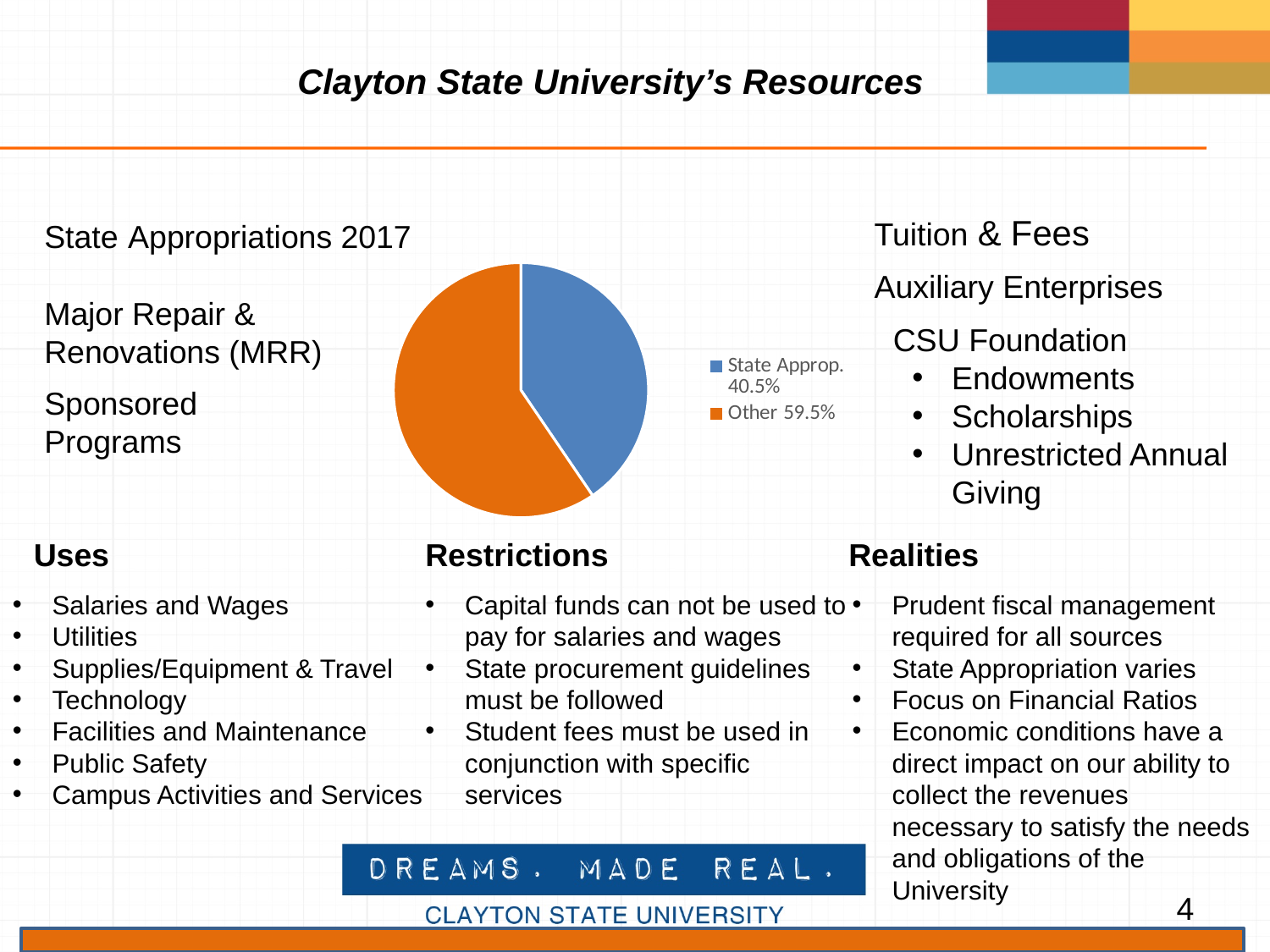
What is the difference in percentage points between the Other slice and the State Approp. slice? 19 percentage points How many slices does the pie chart have? 2 How many entries does the pie chart's legend list? 2 Which is larger in the pie chart, State Approp. or Other? Other Which slice of the pie chart is the largest? Other What colour is the Other slice in the pie chart? orange Which slice of the pie chart is the smallest? State Approp. What kind of chart is shown on the slide? pie chart What share of the pie does State Approp. represent? 40.5% What share of the pie does Other represent? 59.5% What colour is the State Approp. slice in the pie chart? blue